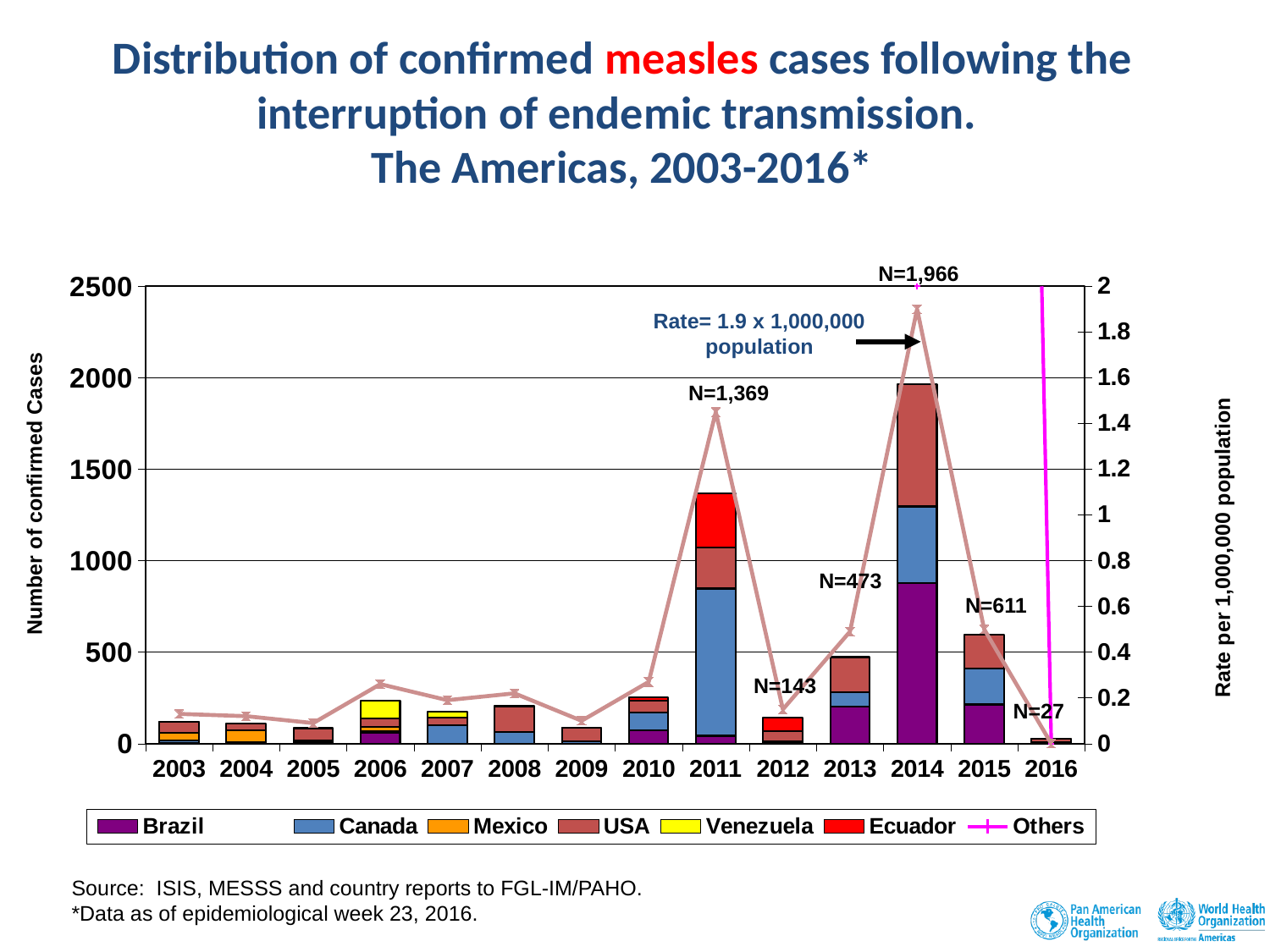
Is the total number of confirmed cases in 2006 greater or less than 500? less What is the total number of confirmed measles cases shown for 2016? 27 What is the difference between the total cases in 2015 and in 2013? 138 Which year has more total confirmed cases, 2013 or 2015? 2015 What is the difference between the total cases in 2014 and in 2011? 597 Which year has the highest total number of confirmed cases? 2014 How many years are shown on the x axis? 14 How many entries does the legend list? 7 What is the rate per 1,000,000 population stated for 2014? 1.9 Which year has the lowest total number of confirmed cases? 2016 What is the total number of confirmed measles cases shown for 2011? 1,369 What is the total number of confirmed measles cases shown for 2014? 1,966